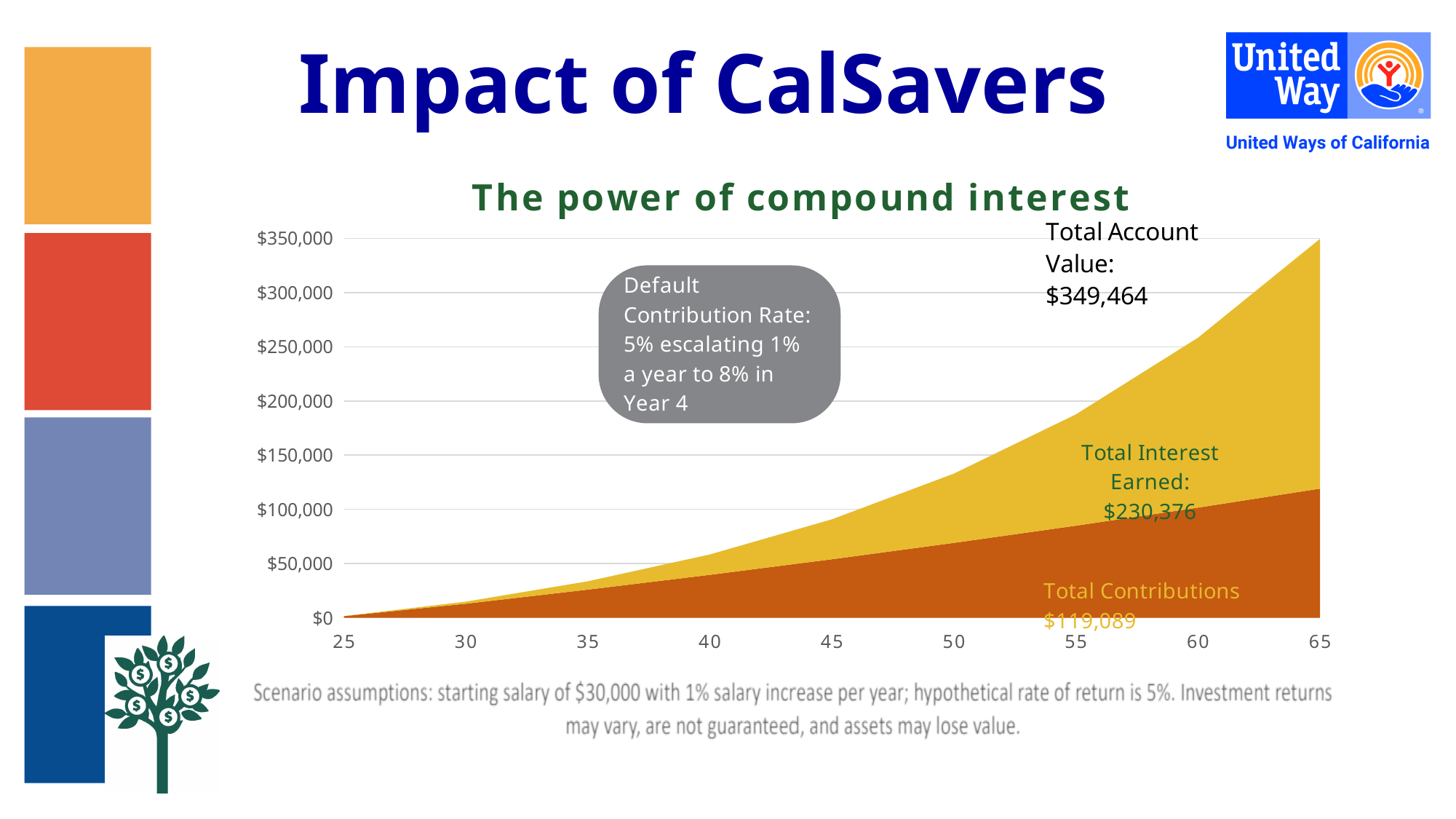
Is the total account value at age 55 greater or less than $200,000? less Does the total account value rise or fall as age increases from 25 to 65? rises Which is larger at the end of the chart, Total Interest Earned or Total Contributions? Total Interest Earned How many age tick labels are shown on the x axis? 9 What is the Total Account Value shown at the end of the chart? $349,464 What is the Total Interest Earned shown on the chart? $230,376 What kind of chart is shown on the slide? area chart What is the title of the chart? The power of compound interest Is the total account value at age 50 greater or less than $100,000? greater By how much does Total Interest Earned exceed Total Contributions? $111,287 What is the Total Contributions value shown on the chart? $119,089 What is the highest value labelled on the y axis? $350,000